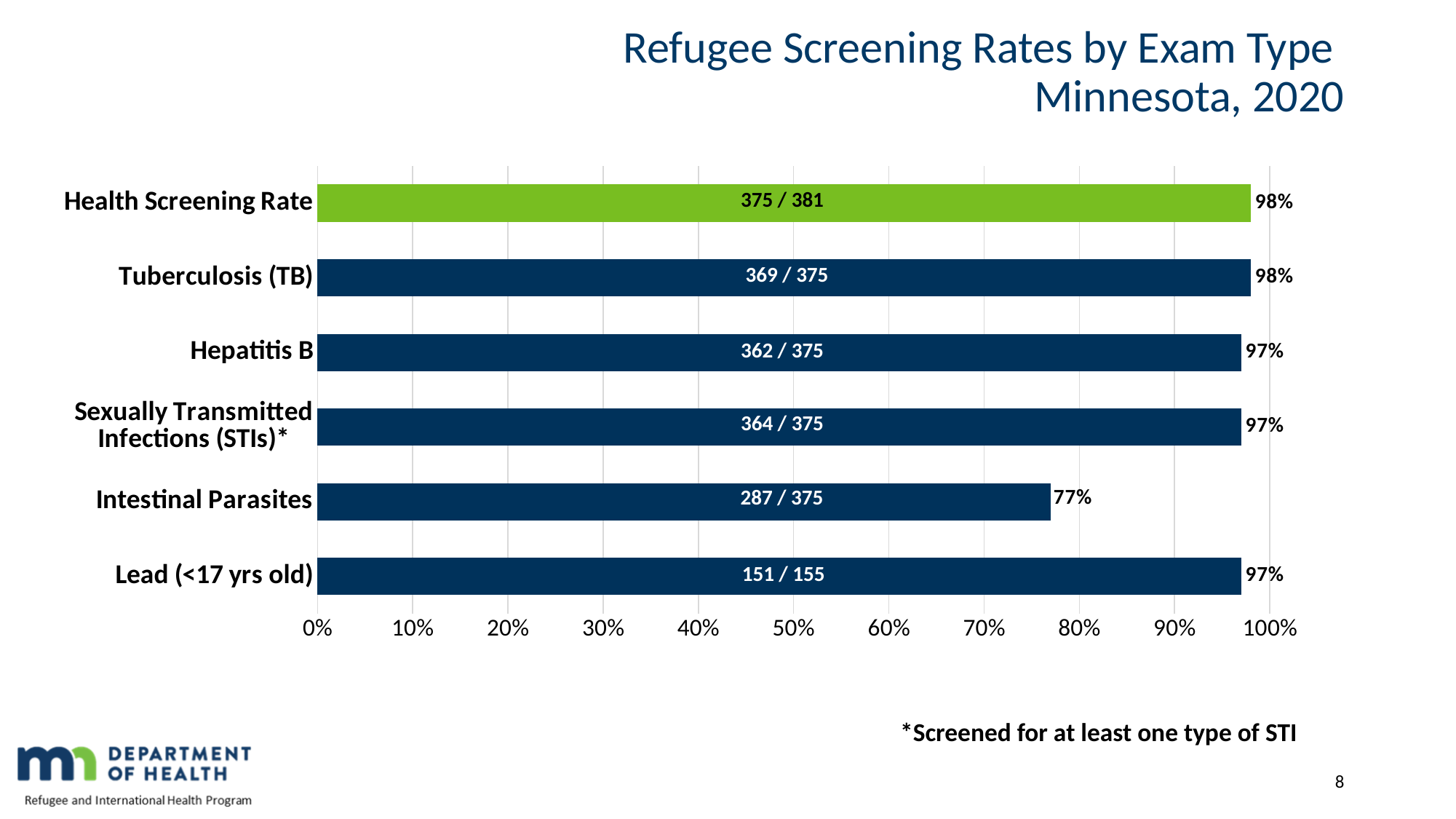
Is the value for Intestinal Parasites greater or less than 80%? less What is the title of the chart? Refugee Screening Rates by Exam Type Minnesota, 2020 What is the difference in percentage points between the Tuberculosis (TB) rate and the Intestinal Parasites rate? 21 Which bar is coloured green rather than dark blue? Health Screening Rate What fraction is shown on the Lead (<17 yrs old) bar? 151 / 155 What is the screening rate for Tuberculosis (TB)? 98% What fraction is shown on the Hepatitis B bar? 362 / 375 What kind of chart is shown on the slide? bar chart What is the screening rate for Intestinal Parasites? 77% Which is larger, the screening rate for Hepatitis B or for Intestinal Parasites? Hepatitis B How many categories (bars) are shown in the chart? 6 Which exam type has the lowest screening rate? Intestinal Parasites